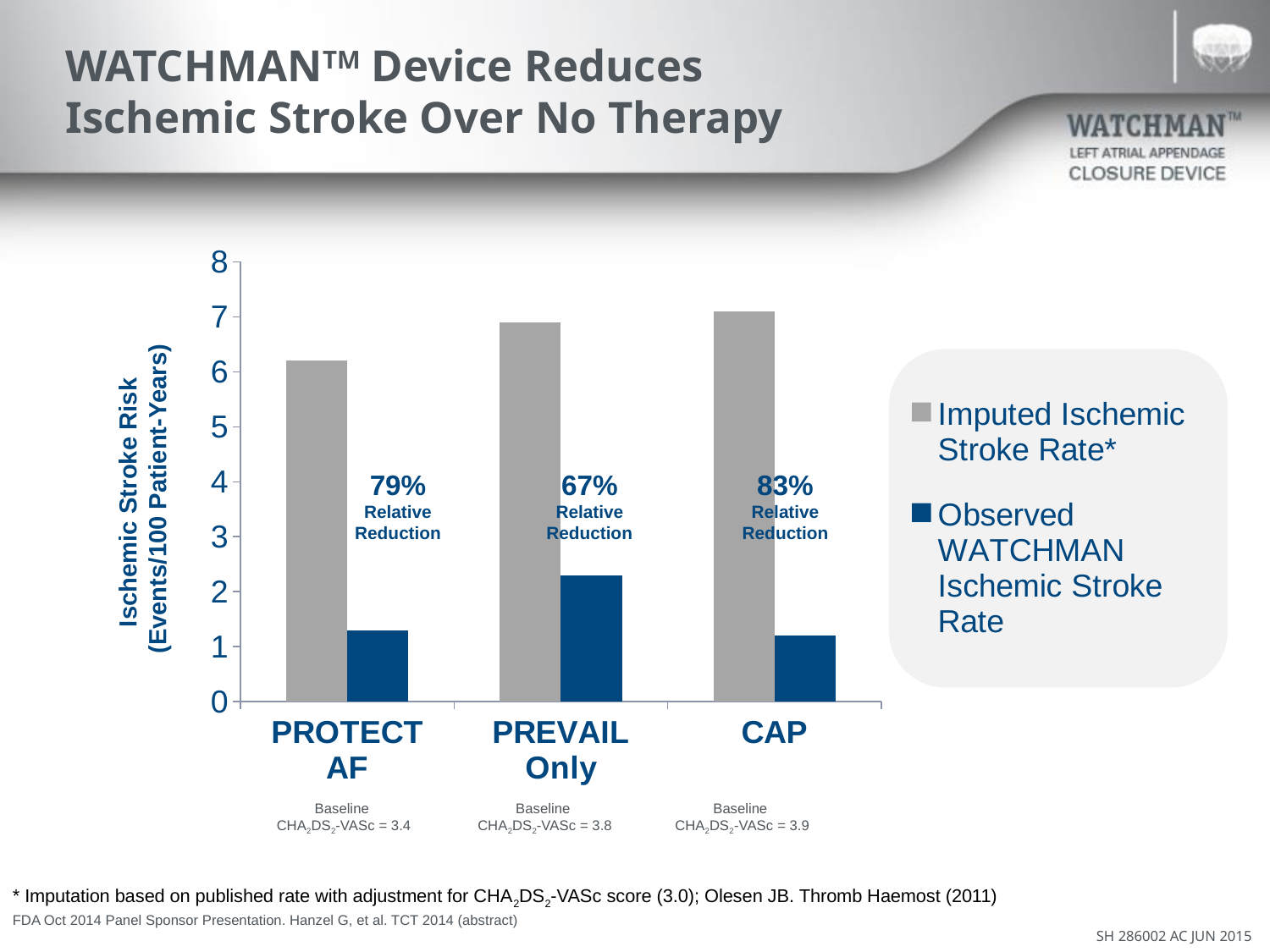
What relative reduction is printed for PROTECT AF? 79% Which category shows the highest relative reduction? CAP What relative reduction is printed for CAP? 83% How many study categories are shown on the x axis of the chart? 3 How many series does the chart legend list? 2 What relative reduction is printed for PREVAIL Only? 67% Which category shows the lowest relative reduction? PREVAIL Only Is the Imputed Ischemic Stroke Rate for PROTECT AF greater or less than 5? greater What kind of chart is shown on the slide? Bar chart What is the difference between the relative reduction for CAP and for PROTECT AF? 4 percentage points Which category has the larger Observed WATCHMAN Ischemic Stroke Rate, PREVAIL Only or PROTECT AF? PREVAIL Only Is the Observed WATCHMAN Ischemic Stroke Rate for PREVAIL Only greater or less than 3? less